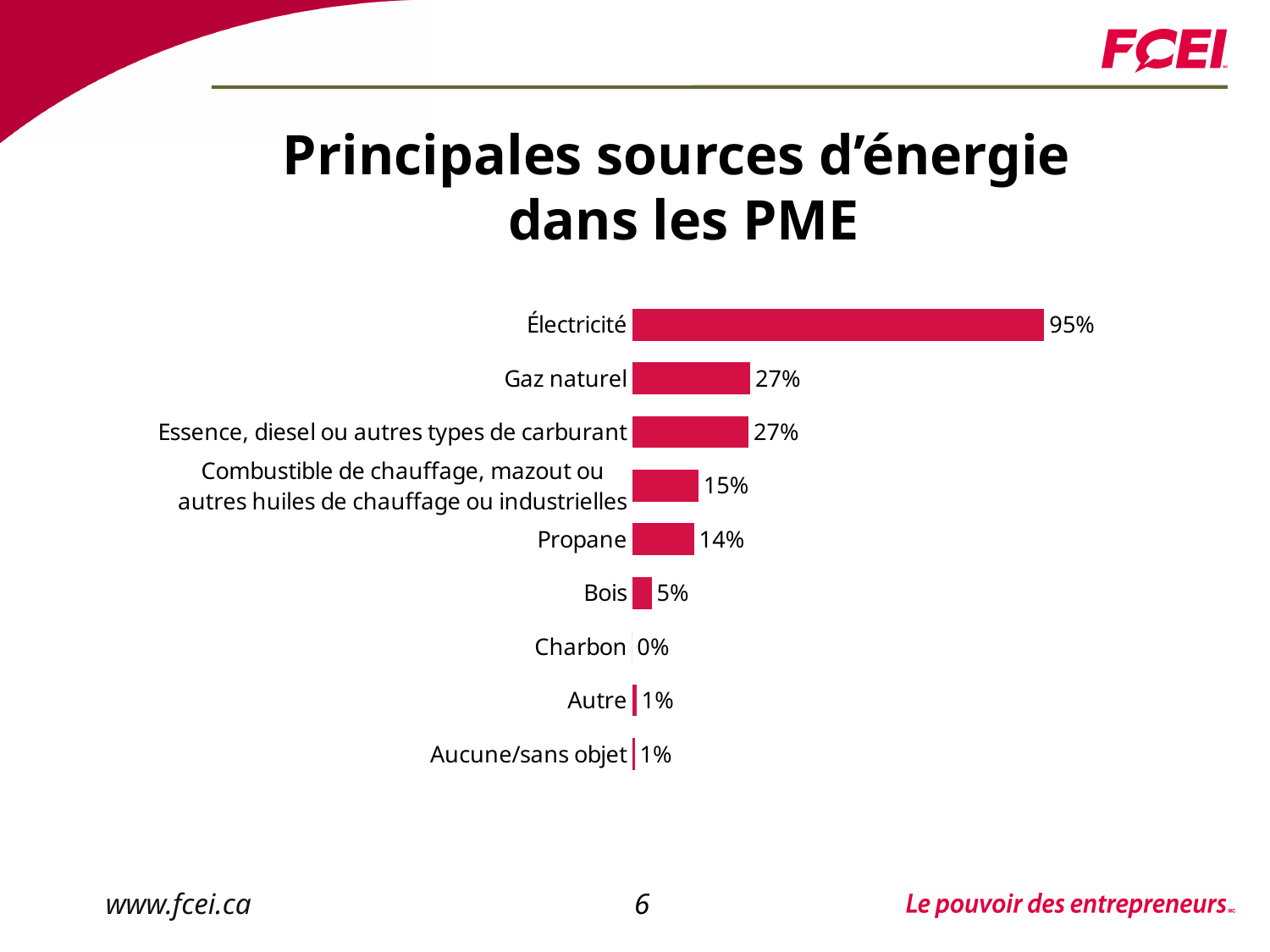
What is the value for Bois? 5% What is the difference between the values for Propane and Bois? 9% Which is larger, the value for Gaz naturel or the value for Propane? Gaz naturel What is the value for Combustible de chauffage, mazout ou autres huiles de chauffage ou industrielles? 15% What kind of chart is shown on the slide? Bar chart Which category has the highest value? Électricité What is the difference between the values for Électricité and Gaz naturel? 68% What is the title of the slide? Principales sources d'énergie dans les PME What is the value for Électricité? 95% How many categories are shown in the chart? 9 Which category has the lowest value? Charbon What is the value for Propane? 14%